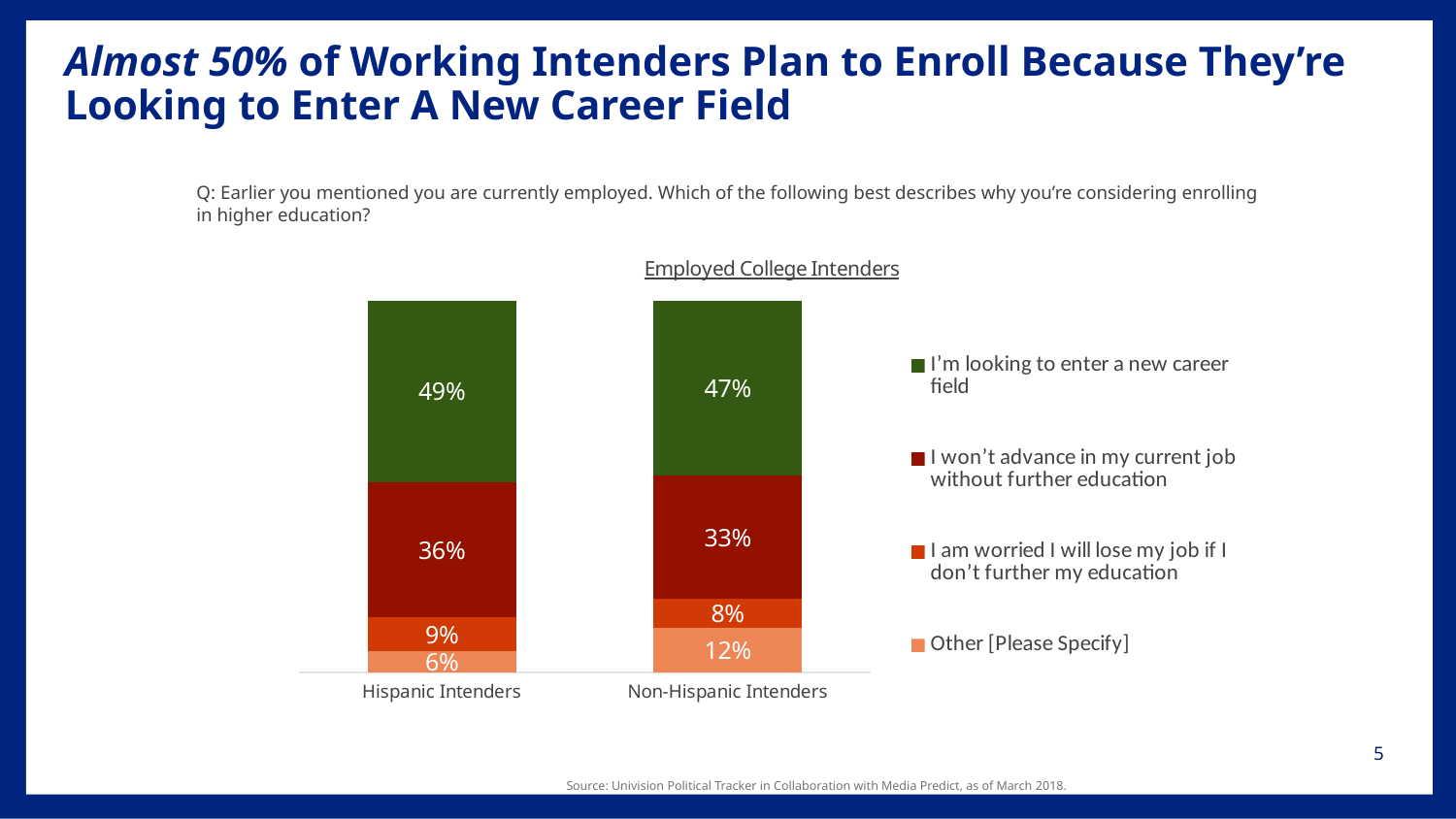
What percentage of Hispanic Intenders say they are looking to enter a new career field? 49% What percentage of Non-Hispanic Intenders say they won't advance in their current job without further education? 33% What kind of chart is shown on the slide? Stacked bar chart Which reason has the highest share among Non-Hispanic Intenders? I'm looking to enter a new career field Which reason has the lowest share among Hispanic Intenders? Other [Please Specify] How many series does the legend list? 4 What percentage of Hispanic Intenders are worried they will lose their job if they don't further their education? 9% What is the difference between the Hispanic and Non-Hispanic Intenders' shares for 'I won't advance in my current job without further education'? 3 percentage points Which group has a larger share for 'Other [Please Specify]', Hispanic Intenders or Non-Hispanic Intenders? Non-Hispanic Intenders How many categories (groups) are shown on the x axis? 2 What is the total of the stacked bar for Hispanic Intenders? 100% What percentage of Non-Hispanic Intenders chose 'Other [Please Specify]'? 12%